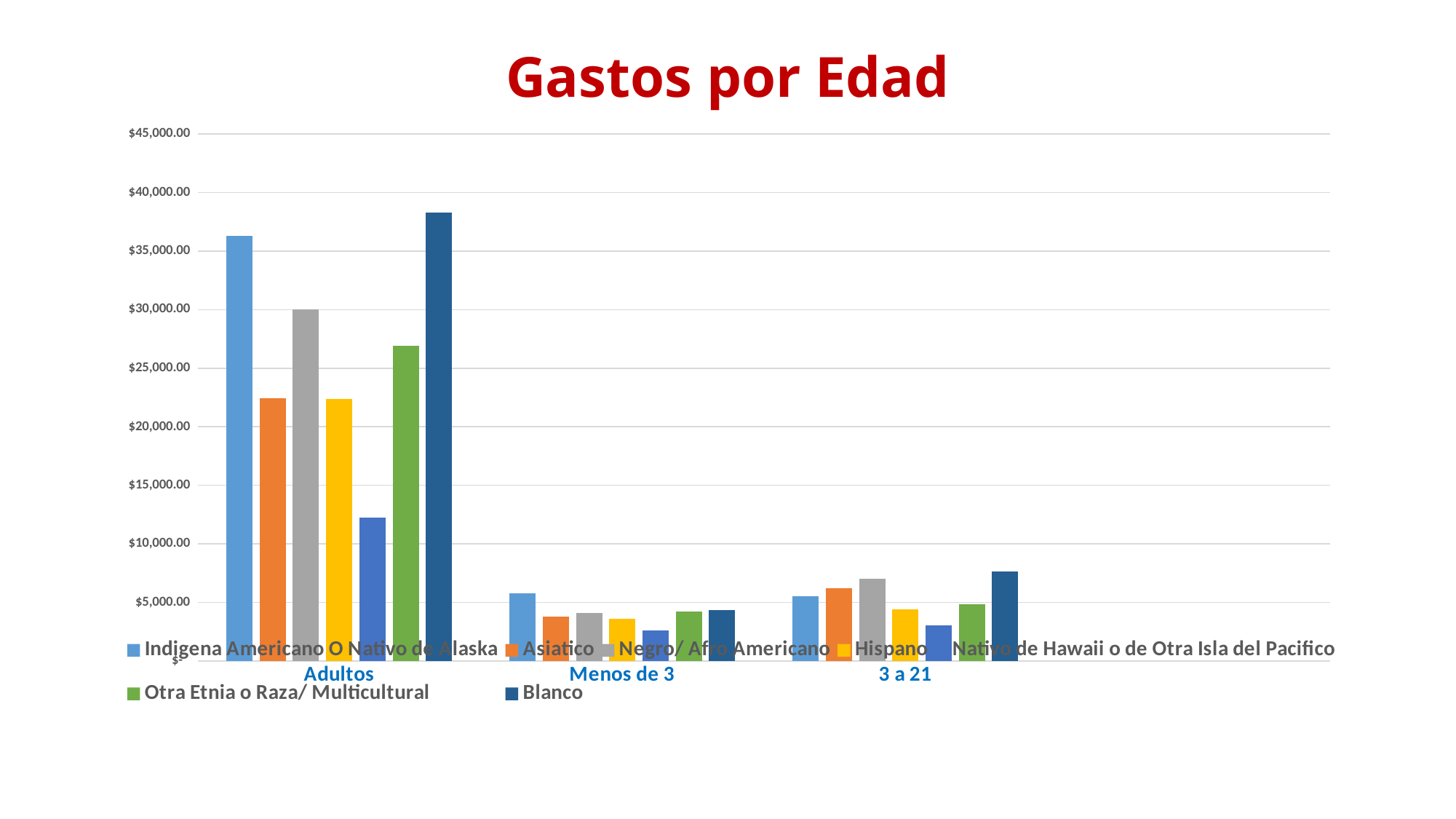
What kind of chart is shown on the slide? bar chart In the Adultos category, which series has the highest value? Blanco How many series does the legend list? 7 In the 3 a 21 category, which series has the highest value? Blanco In the Menos de 3 category, which series has the lowest value? Nativo de Hawaii o de Otra Isla del Pacifico What is the title of the chart? Gastos por Edad In the Adultos category, which is larger: Indigena Americano O Nativo de Alaska or Asiatico? Indigena Americano O Nativo de Alaska Is the value for Asiatico in the Adultos category greater or less than $20,000.00? greater Is the value for Nativo de Hawaii o de Otra Isla del Pacifico in the Adultos category greater or less than $15,000.00? less Is the value for Blanco in the Adultos category greater or less than $35,000.00? greater In the Adultos category, which series has the lowest value? Nativo de Hawaii o de Otra Isla del Pacifico How many age categories are shown on the x axis? 3